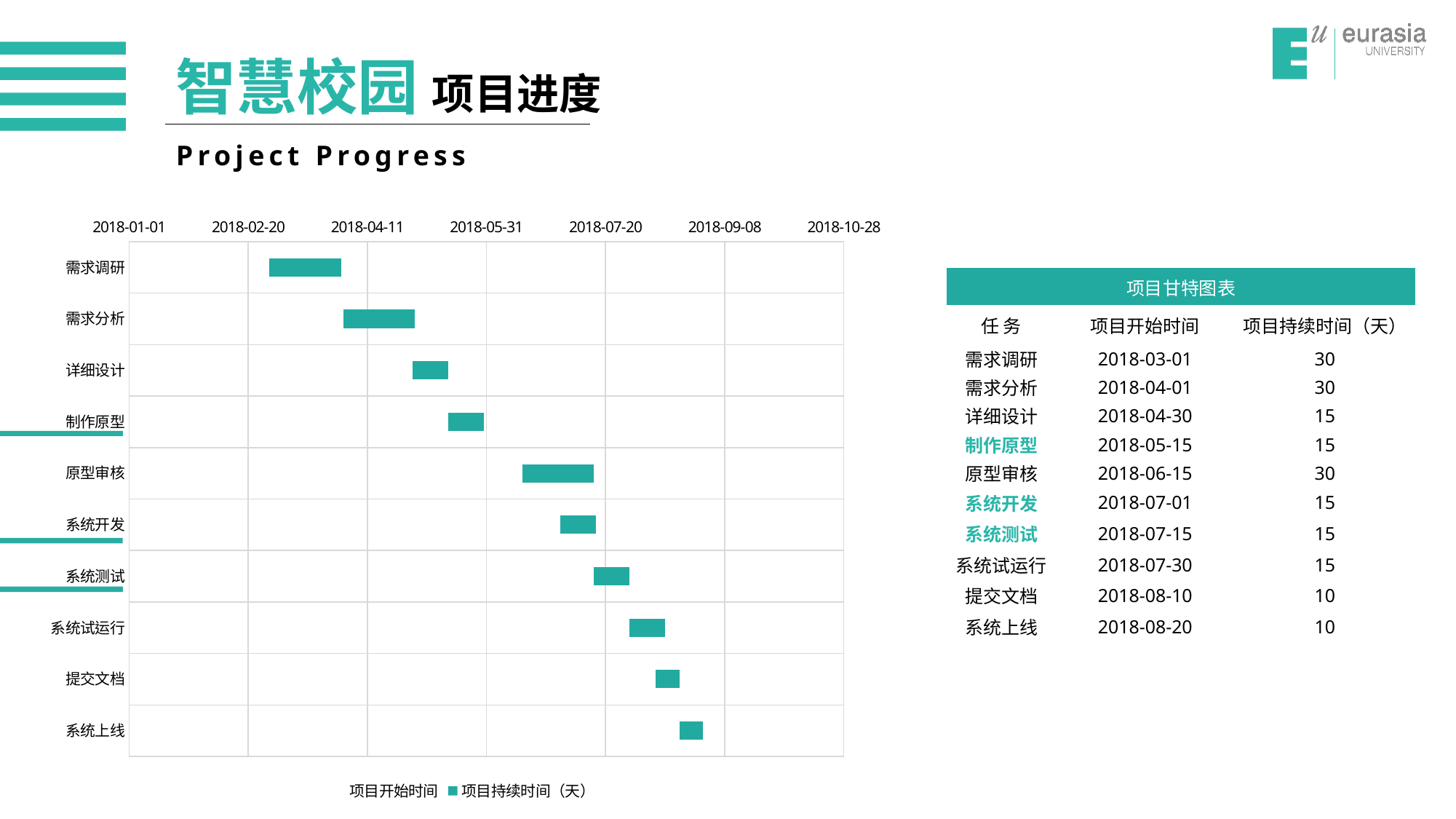
How many series does the chart legend list? 2 What are the two series names shown in the chart legend? 项目开始时间 and 项目持续时间（天） What kind of chart is shown on the slide? Bar chart (Gantt chart) According to the slide, what is the duration in days of the 需求调研 task? 30 How many tasks are listed on the vertical axis of the chart? 10 Which task has the longer bar in the chart, 需求调研 or 详细设计? 需求调研 Does the bar for 需求调研 start before or after the 2018-02-20 axis tick? after Moving down the task list from 需求调研 to 系统上线, do the bars start later or earlier along the date axis? later According to the slide, what is the duration in days of the 提交文档 task? 10 According to the slide, what is the start date of the 系统上线 task? 2018-08-20 What is the difference in duration (days) between 需求分析 and 制作原型? 15 What is the first date label on the horizontal axis of the chart? 2018-01-01